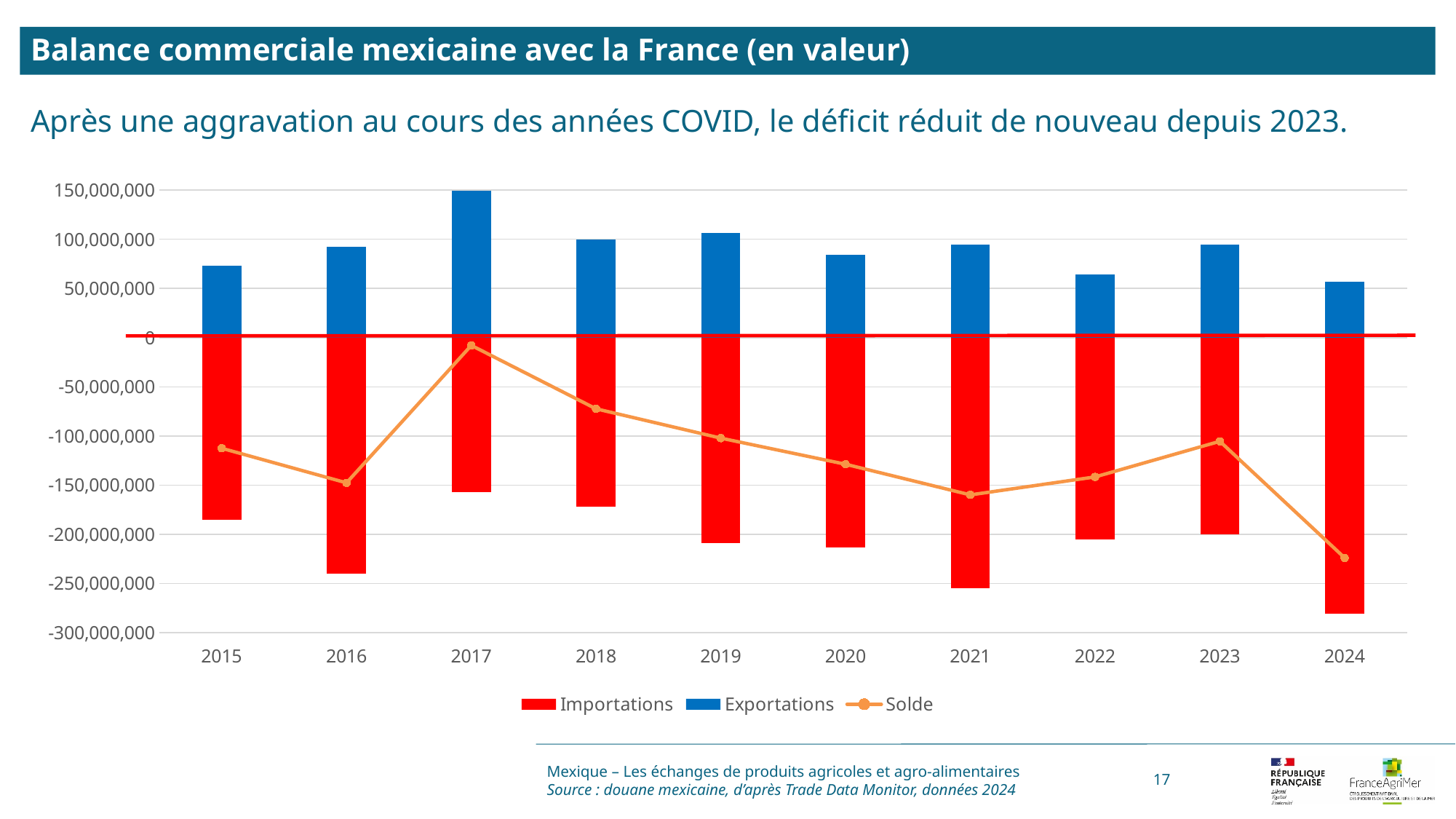
What kind of chart is shown on the slide? A bar chart combined with a line In which year are Exportations highest? 2017 In which year is the Solde lowest? 2024 How many years are shown on the x axis of the chart? 10 In which year do Importations reach their largest negative value? 2024 How many series does the chart legend list? 3 In which year are Exportations lowest? 2024 In which year is the Solde closest to zero (highest)? 2017 Does the Solde line rise or fall between 2023 and 2024? It falls Is the Exportations value for 2017 greater or less than 100,000,000? greater Which year has the larger Exportations value, 2019 or 2020? 2019 Is the Importations value for 2024 greater or less than -250,000,000? less